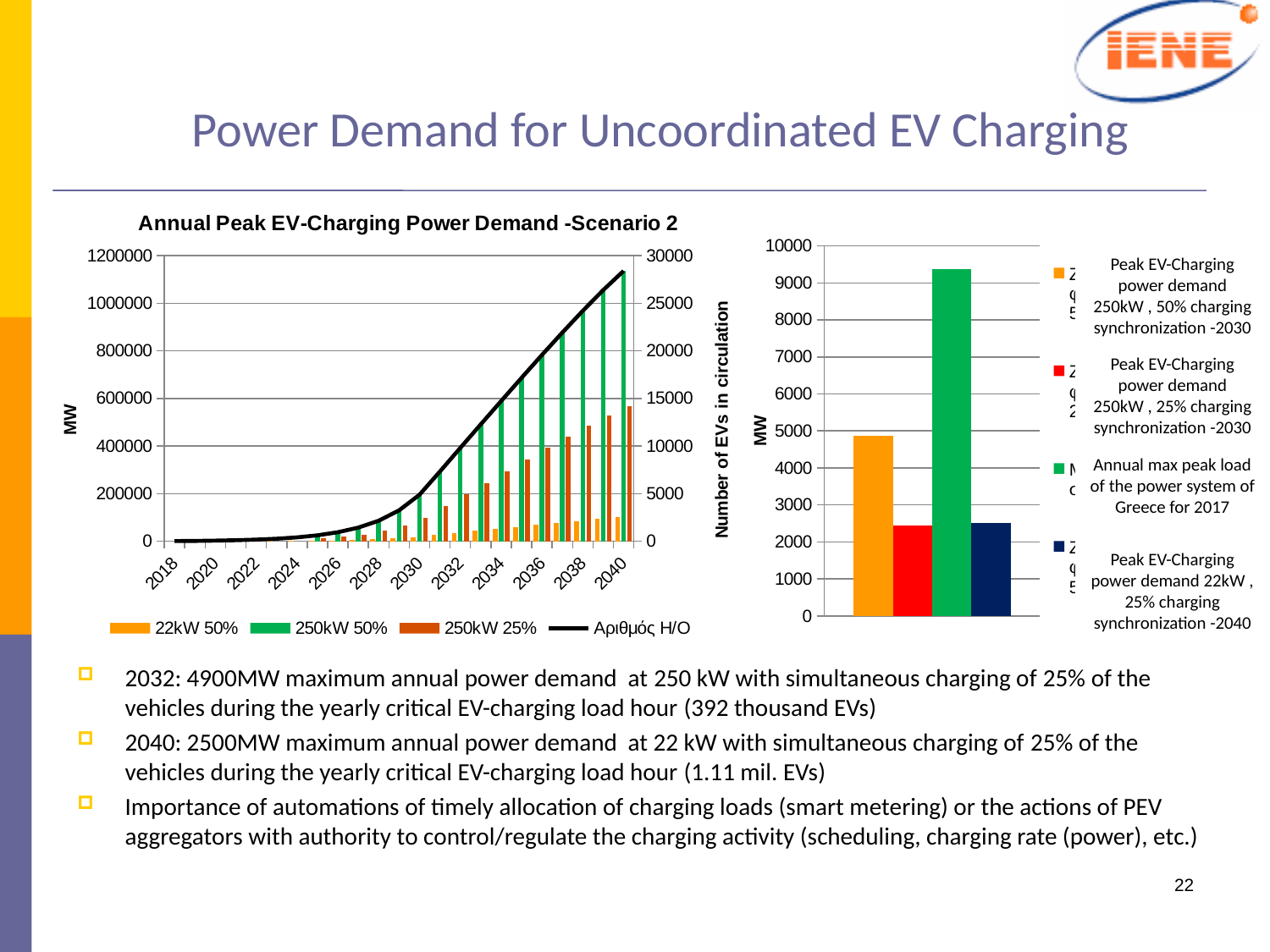
In the right chart, is the value for Peak EV-Charging power demand 250kW, 50% charging synchronization -2030 greater or less than 4000? greater In the left chart (Annual Peak EV-Charging Power Demand -Scenario 2), what is the label of the right-hand vertical axis? Number of EVs in circulation In the left chart (Annual Peak EV-Charging Power Demand -Scenario 2), which is larger in 2040: the 250kW 50% bar or the 250kW 25% bar? 250kW 50% In the left chart (Annual Peak EV-Charging Power Demand -Scenario 2), is the Αριθμός Η/Ο line value for 2040 greater or less than 25000 on the right axis? greater In the right chart, which bar is the highest? Annual max peak load of the power system of Greece for 2017 In the right chart, is the value for Annual max peak load of the power system of Greece for 2017 greater or less than 9000? greater In the left chart (Annual Peak EV-Charging Power Demand -Scenario 2), does the black line (Αριθμός Η/Ο) rise or fall from 2018 to 2040? rise What is the title of the chart on the left of the slide? Annual Peak EV-Charging Power Demand -Scenario 2 In the left chart (Annual Peak EV-Charging Power Demand -Scenario 2), how many series does the legend list? 4 In the right chart, how many bars are plotted? 4 What kind of chart is the chart on the right of the slide? bar chart